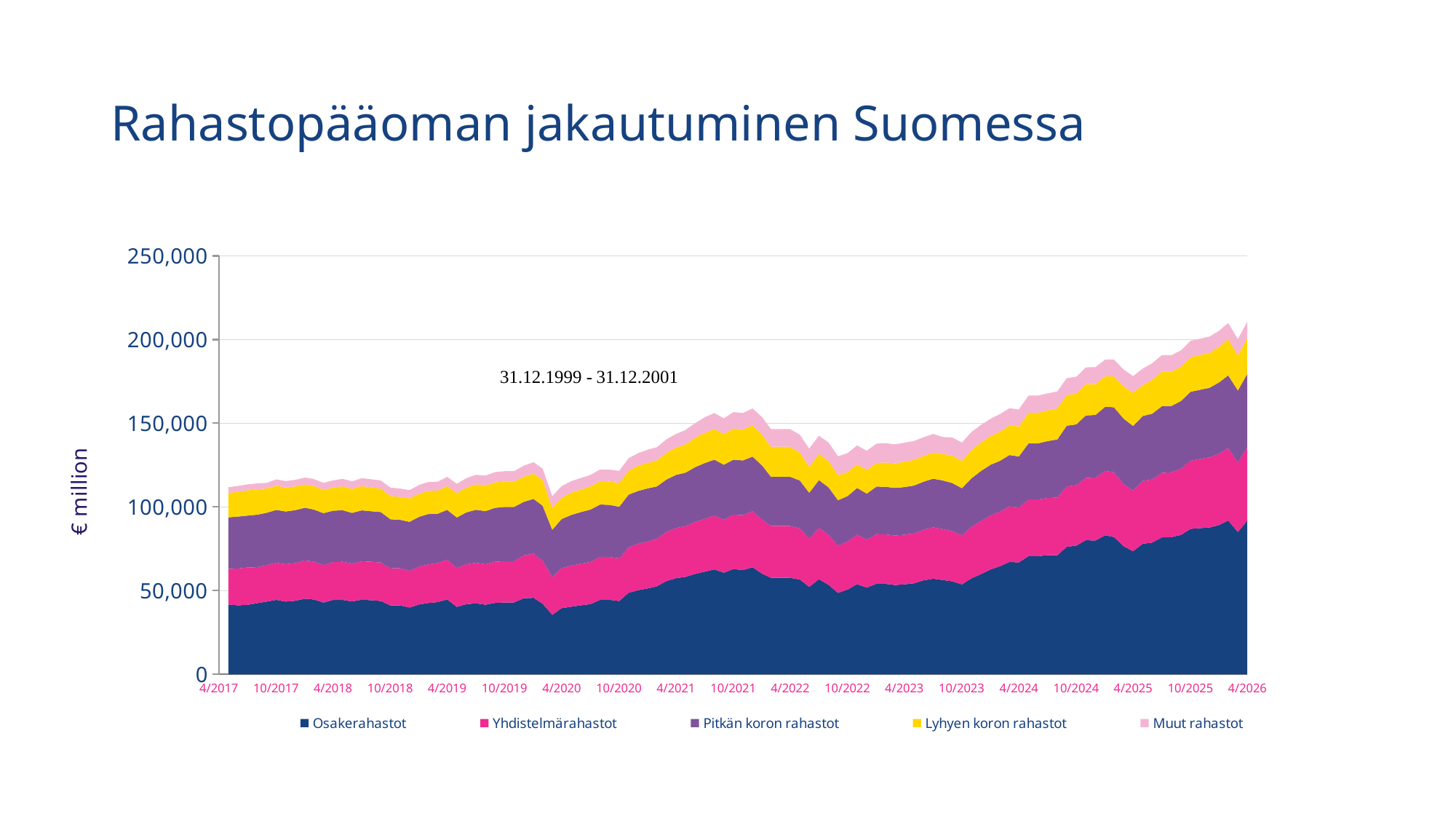
Is the total fund capital at 4/2026 greater or less than 200,000? greater How many series does the legend list? 5 Is the value for Osakerahastot at 4/2017 greater or less than 50,000? less Is the value for Osakerahastot at 4/2026 greater or less than 50,000? greater What kind of chart is shown on the slide? Stacked area chart What is the title of the chart? Rahastopääoman jakautuminen Suomessa Does the total fund capital rise or fall overall from 4/2017 to 4/2026? rise How many date labels are shown on the x axis? 19 What is the label on the vertical axis? € million